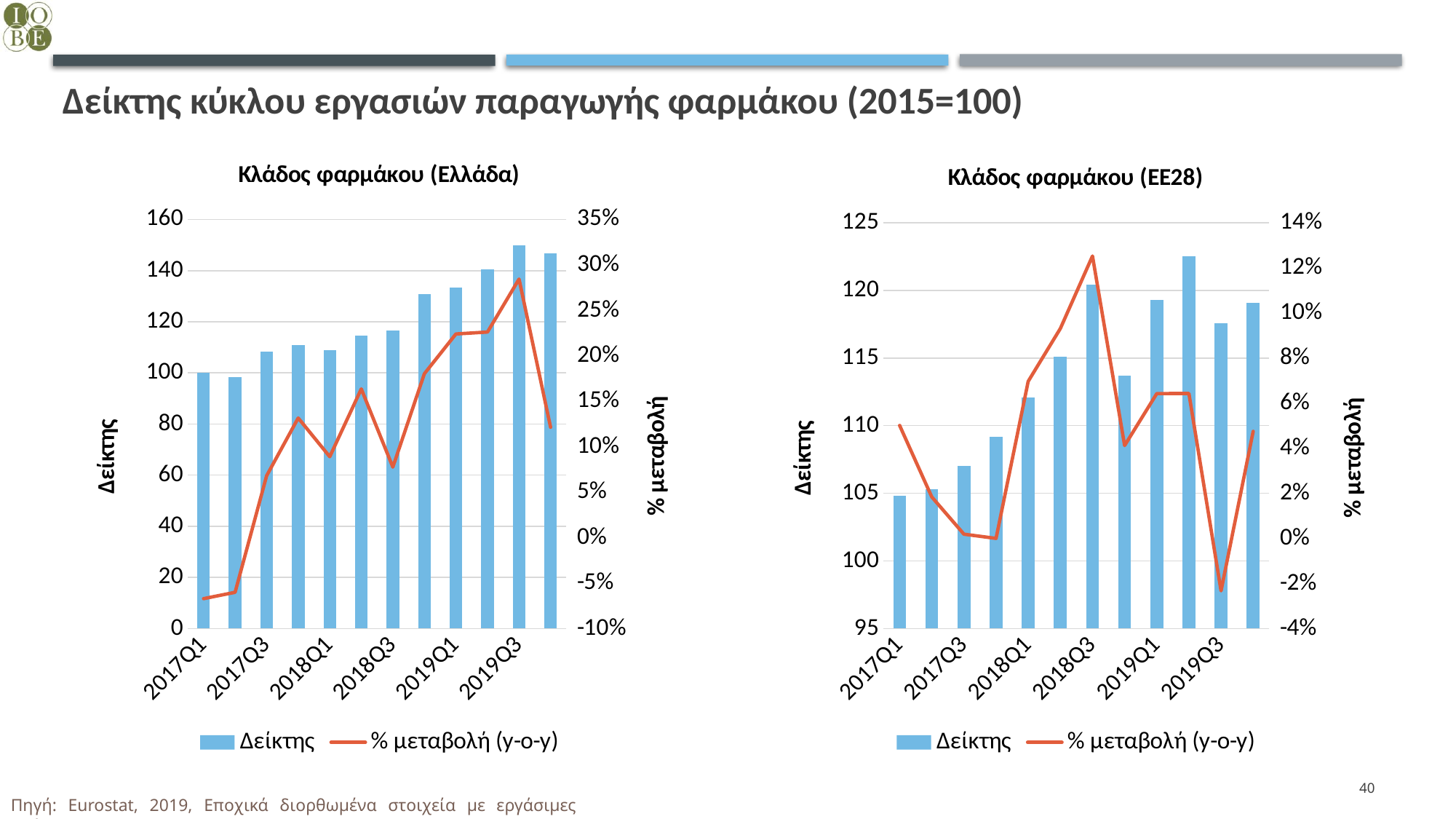
In the 'Κλάδος φαρμάκου (Ελλάδα)' chart, is the Δείκτης value for 2018Q1 greater or less than 120? less How many series does the legend of the 'Κλάδος φαρμάκου (ΕΕ28)' chart list? 2 What kind of chart is the 'Κλάδος φαρμάκου (Ελλάδα)' chart? Combined bar and line chart In the 'Κλάδος φαρμάκου (Ελλάδα)' chart, is the Δείκτης value for 2019Q3 greater or less than 140? greater What is the title of the right-hand vertical axis in the 'Κλάδος φαρμάκου (ΕΕ28)' chart? % μεταβολή In the 'Κλάδος φαρμάκου (Ελλάδα)' chart, in which quarter does the % μεταβολή (y-o-y) line reach its highest point? 2019Q3 In the 'Κλάδος φαρμάκου (ΕΕ28)' chart, which is larger, the Δείκτης value for 2018Q1 or for 2019Q1? 2019Q1 In the 'Κλάδος φαρμάκου (Ελλάδα)' chart, do the Δείκτης bars generally rise or fall from 2017Q1 to 2019Q3? rise In the 'Κλάδος φαρμάκου (ΕΕ28)' chart, is the Δείκτης value for 2018Q3 greater or less than 110? greater In the 'Κλάδος φαρμάκου (Ελλάδα)' chart, which quarter has the highest Δείκτης bar? 2019Q3 In the 'Κλάδος φαρμάκου (ΕΕ28)' chart, in which quarter does the % μεταβολή (y-o-y) line reach its lowest point? 2019Q3 How many bars are plotted in the 'Κλάδος φαρμάκου (Ελλάδα)' chart? 12